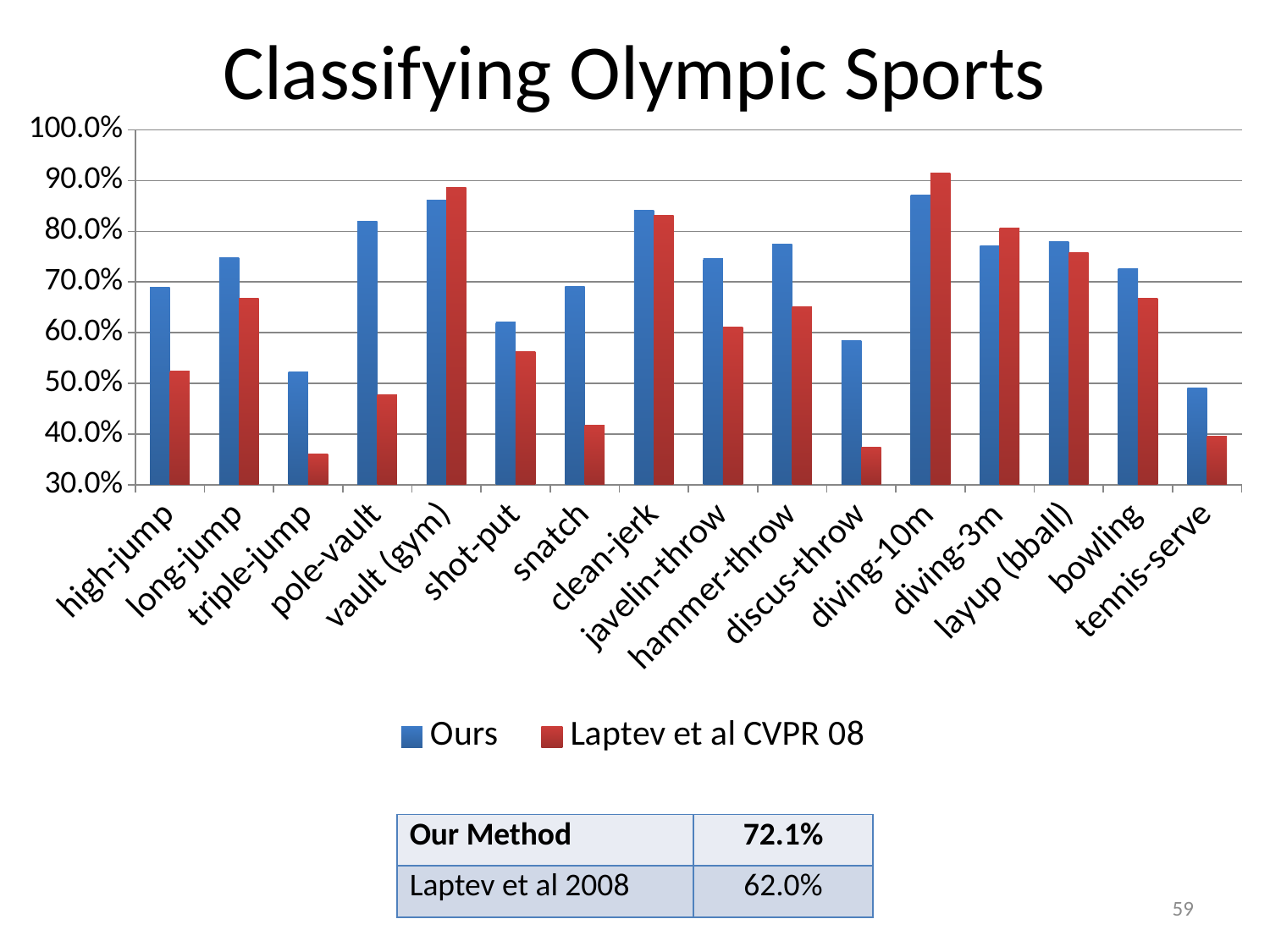
For discus-throw, which series has the larger value, Ours or Laptev et al CVPR 08? Ours How many sport categories are shown on the x axis? 16 For the Laptev et al CVPR 08 series, which sport has the highest value? diving-10m Is the value for Laptev et al CVPR 08 on snatch greater or less than 50.0%? less Is the value for Ours on pole-vault greater or less than 80.0%? greater For high-jump, which series has the larger value, Ours or Laptev et al CVPR 08? Ours For diving-10m, which series has the larger value, Ours or Laptev et al CVPR 08? Laptev et al CVPR 08 What kind of chart is shown on the slide? bar chart Is the value for Ours on clean-jerk greater or less than 80.0%? greater How many series does the legend list? 2 What are the two legend entries of the chart? Ours; Laptev et al CVPR 08